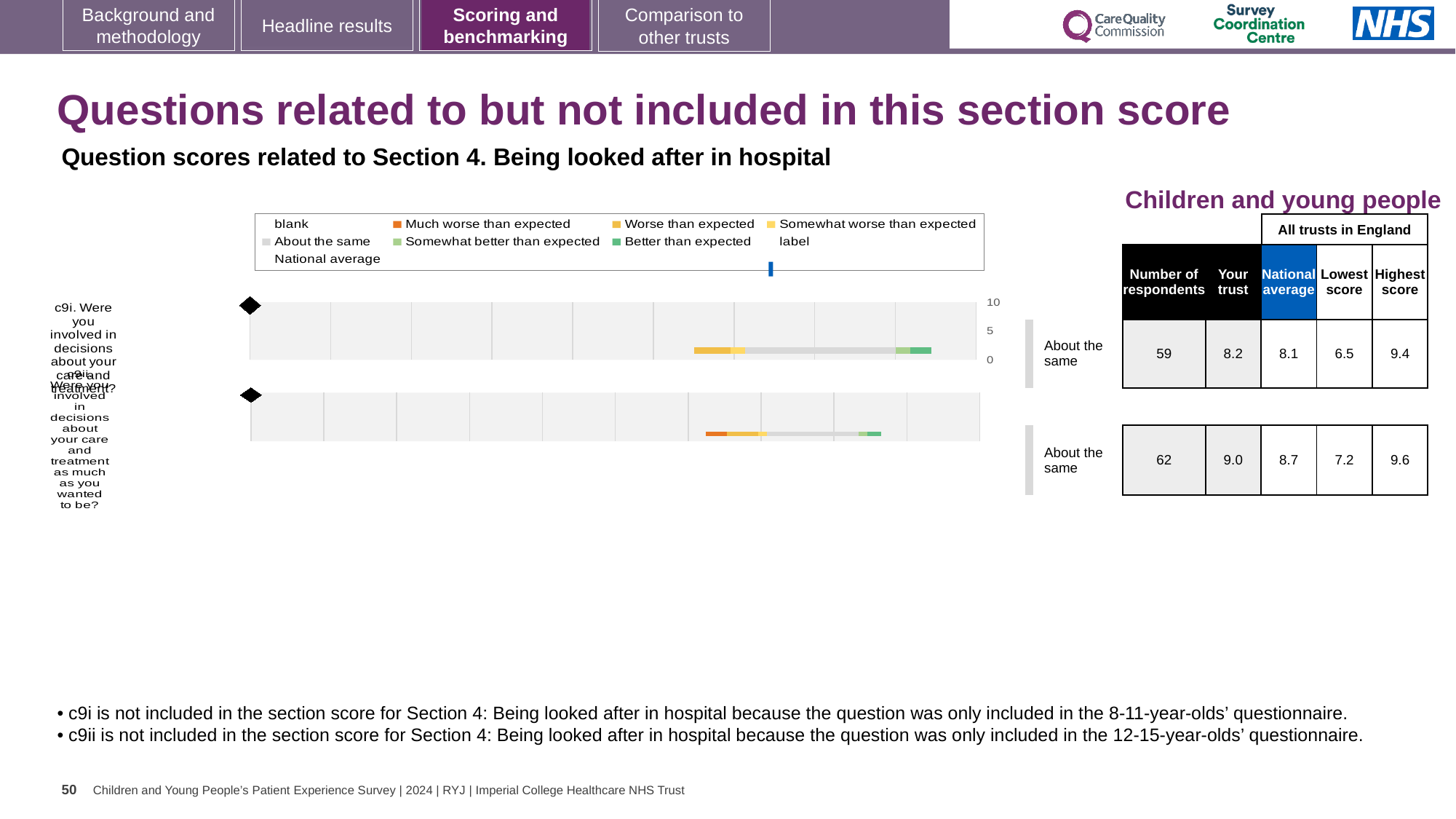
What benchmark category is shown next to the c9i bar? About the same In the table beside the chart, how many respondents answered c9i? 59 What benchmark category is shown next to the c9ii bar? About the same In the table beside the chart, what is the national average for c9ii (Were you involved in decisions about your care and treatment as much as you wanted to be?)? 8.7 What kind of chart is shown on the slide? bar chart In the table beside the chart, what is the difference between the 'Your trust' score and the national average for c9ii? 0.3 In the table beside the chart, what is the highest score among all trusts in England for c9ii? 9.6 In the table beside the chart, which question has more respondents, c9i or c9ii? c9ii How many question bars (rows) does the chart show? 2 Which legend entry is shown in orange? Much worse than expected In the table beside the chart, what is the 'Your trust' score for c9i (Were you involved in decisions about your care and treatment?)? 8.2 What is the highest value shown on the chart's numeric axis? 10